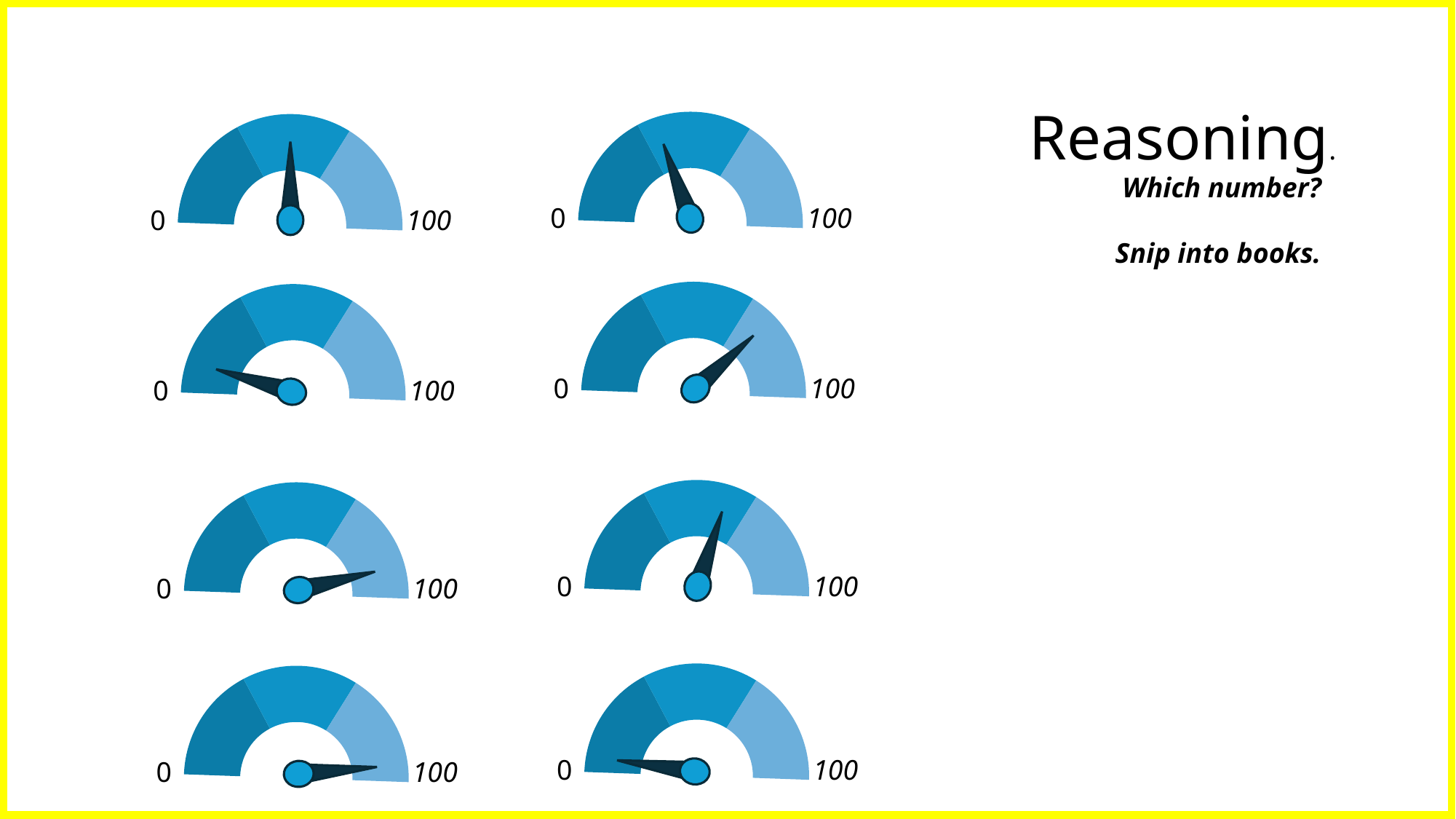
Which gauge shows the larger value, the right gauge in the bottom row or the right gauge in the third row? The right gauge in the third row Which gauge shows the larger value, the left gauge in the second row or the left gauge in the third row? The left gauge in the third row What is the title text at the top right of the slide? Reasoning. How many gauge charts are on the slide? 8 What kind of charts are shown on the slide? Gauge charts In the third row, which gauge shows the larger value, the left one or the right one? The left one What are the two scale values printed at the ends of each gauge? 0 and 100